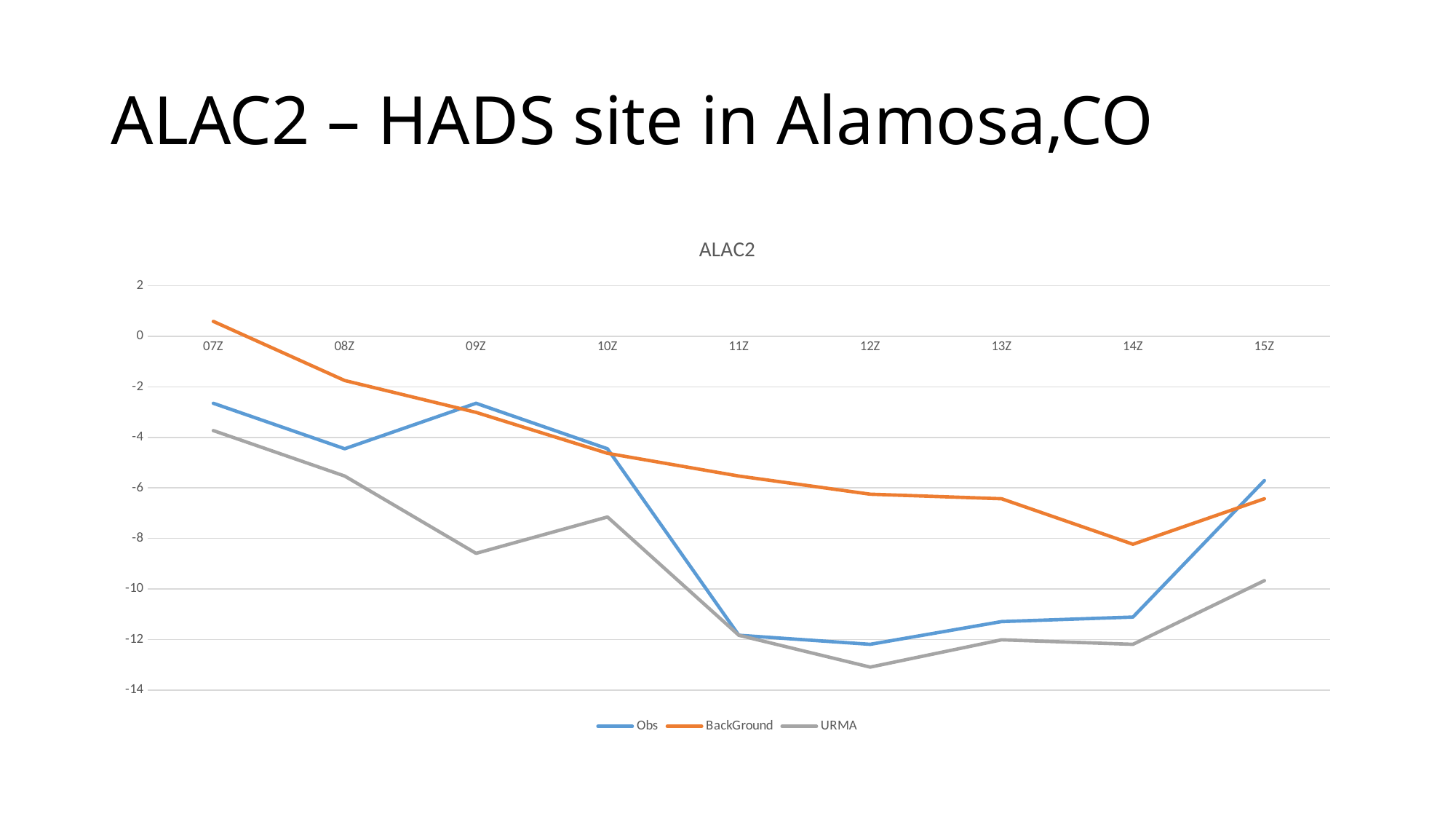
Is the Obs value at 15Z greater or less than -8? greater What is the title of the chart? ALAC2 Is the URMA value at 12Z greater or less than -12? less At 09Z, which series has the larger value, Obs or URMA? Obs Is the Obs value at 11Z greater or less than -10? less At 14Z, which series has the larger value, BackGround or Obs? BackGround At which time does the URMA series reach its lowest value? 12Z How many time points are plotted along the x axis? 9 What kind of chart is shown on the slide? line chart Which series is drawn in orange? BackGround How many series does the legend list? 3